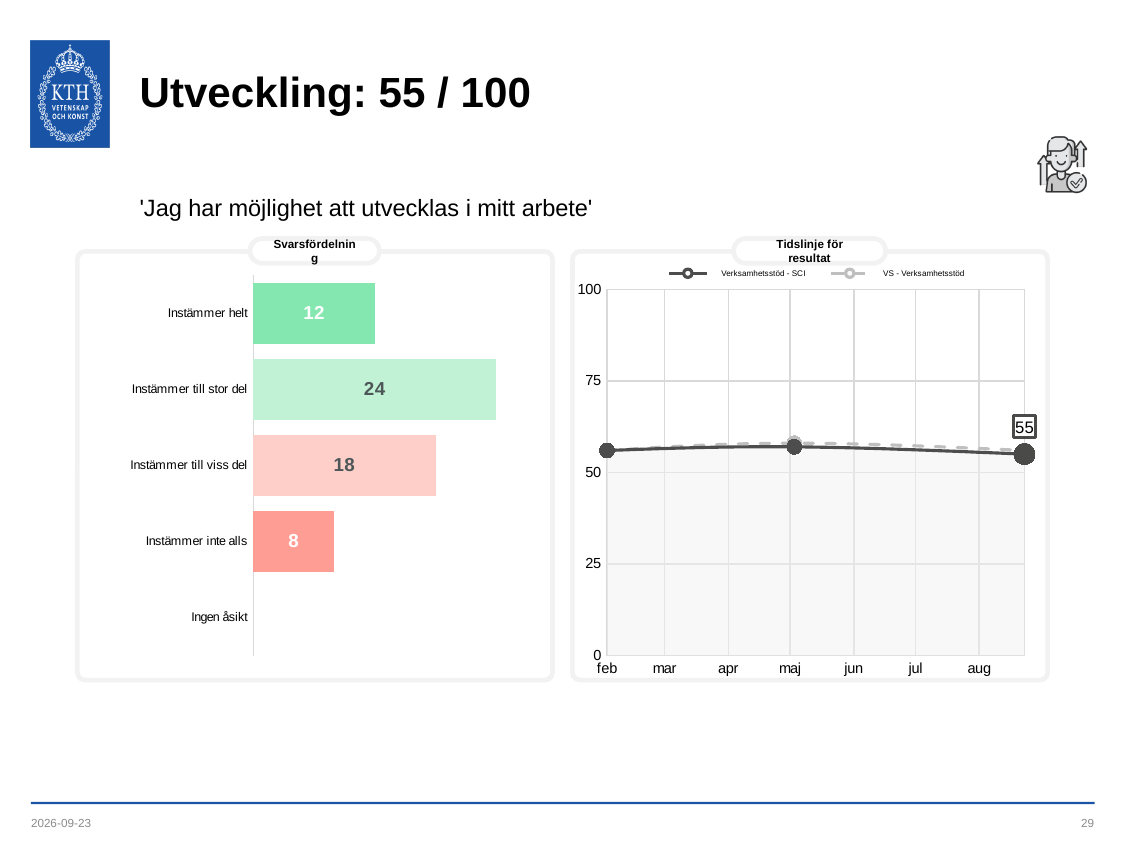
In the 'Tidslinje för resultat' chart, what is the labelled value for aug? 55 How many categories are listed on the vertical axis of the 'Svarsfördelning' chart? 5 How many series does the legend of the 'Tidslinje för resultat' chart list? 2 In the 'Svarsfördelning' chart, what is the difference between 'Instämmer till stor del' and 'Instämmer till viss del'? 6 In the 'Svarsfördelning' chart, what is the value for 'Instämmer till stor del'? 24 In the 'Svarsfördelning' chart, which is larger: 'Instämmer helt' or 'Instämmer till viss del'? Instämmer till viss del What kind of chart is the 'Svarsfördelning' chart? Bar chart In the 'Svarsfördelning' chart, which category has the highest value? Instämmer till stor del How many months are shown on the x axis of the 'Tidslinje för resultat' chart? 7 In the 'Svarsfördelning' chart, which category with a labelled bar has the lowest value? Instämmer inte alls In the 'Tidslinje för resultat' chart, is the value for feb greater or less than 75? less In the 'Svarsfördelning' chart, what is the value for 'Instämmer inte alls'? 8